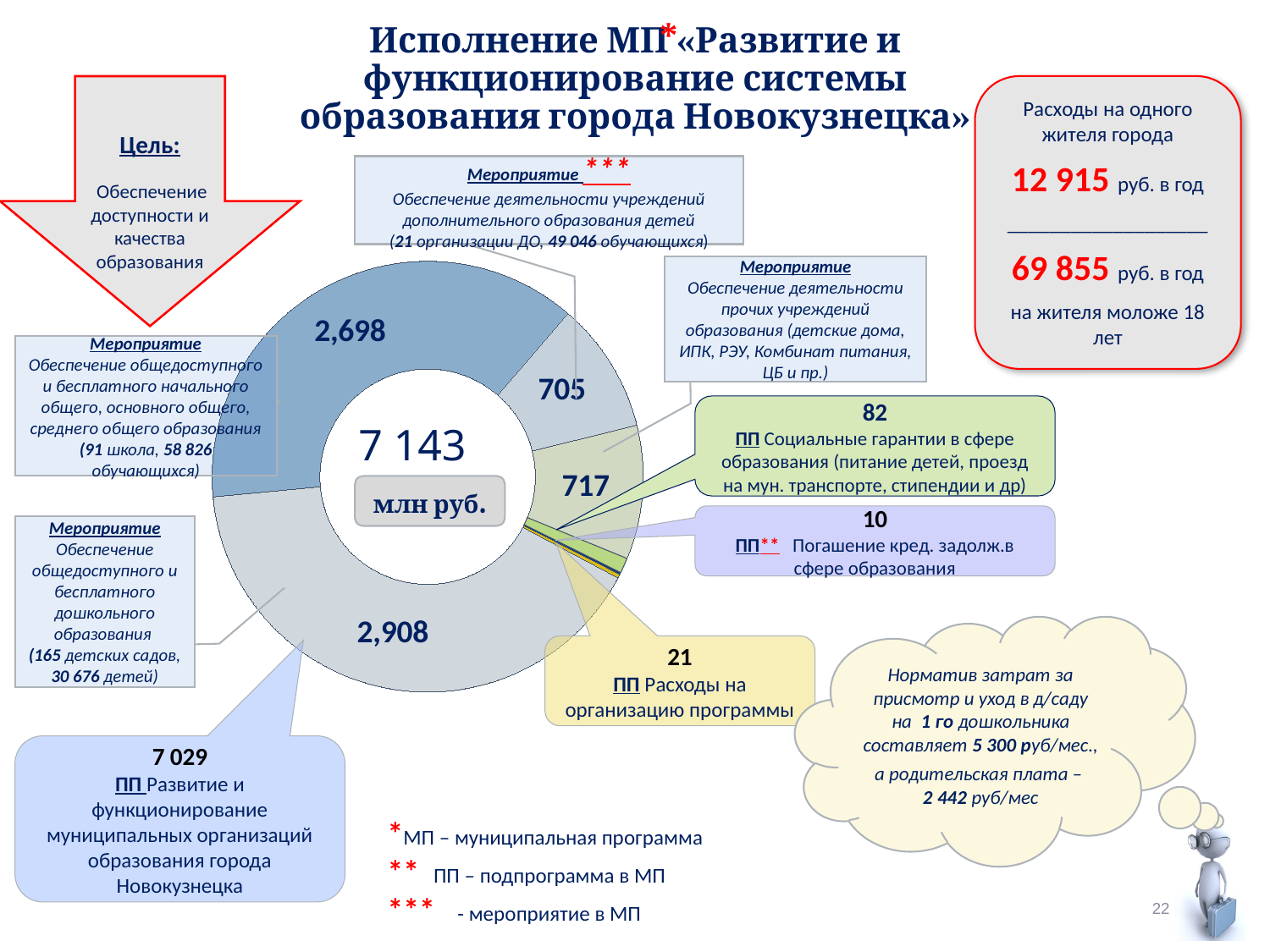
How many values are printed directly on the slices of the doughnut chart? 4 What kind of chart is shown on the slide? Doughnut (pie) chart Of the four values printed directly on the doughnut slices, which is the smallest? 705 What value is shown in the callout for 'ПП Социальные гарантии в сфере образования'? 82 What value is shown in the callout for 'ПП Расходы на организацию программы'? 21 What is the value of the largest slice of the doughnut chart? 2,908 What total value is printed in the centre of the doughnut chart? 7 143 млн руб. Which slice is larger: the one labelled 2,908 or the one labelled 2,698? 2,908 What is the difference between the slice labelled 2,908 and the slice labelled 2,698? 210 Which value is printed on the dark blue slice in the upper left of the doughnut chart? 2,698 Which slice is larger: the one labelled 717 or the one labelled 705? 717 What is the difference between the slice labelled 717 and the slice labelled 705? 12